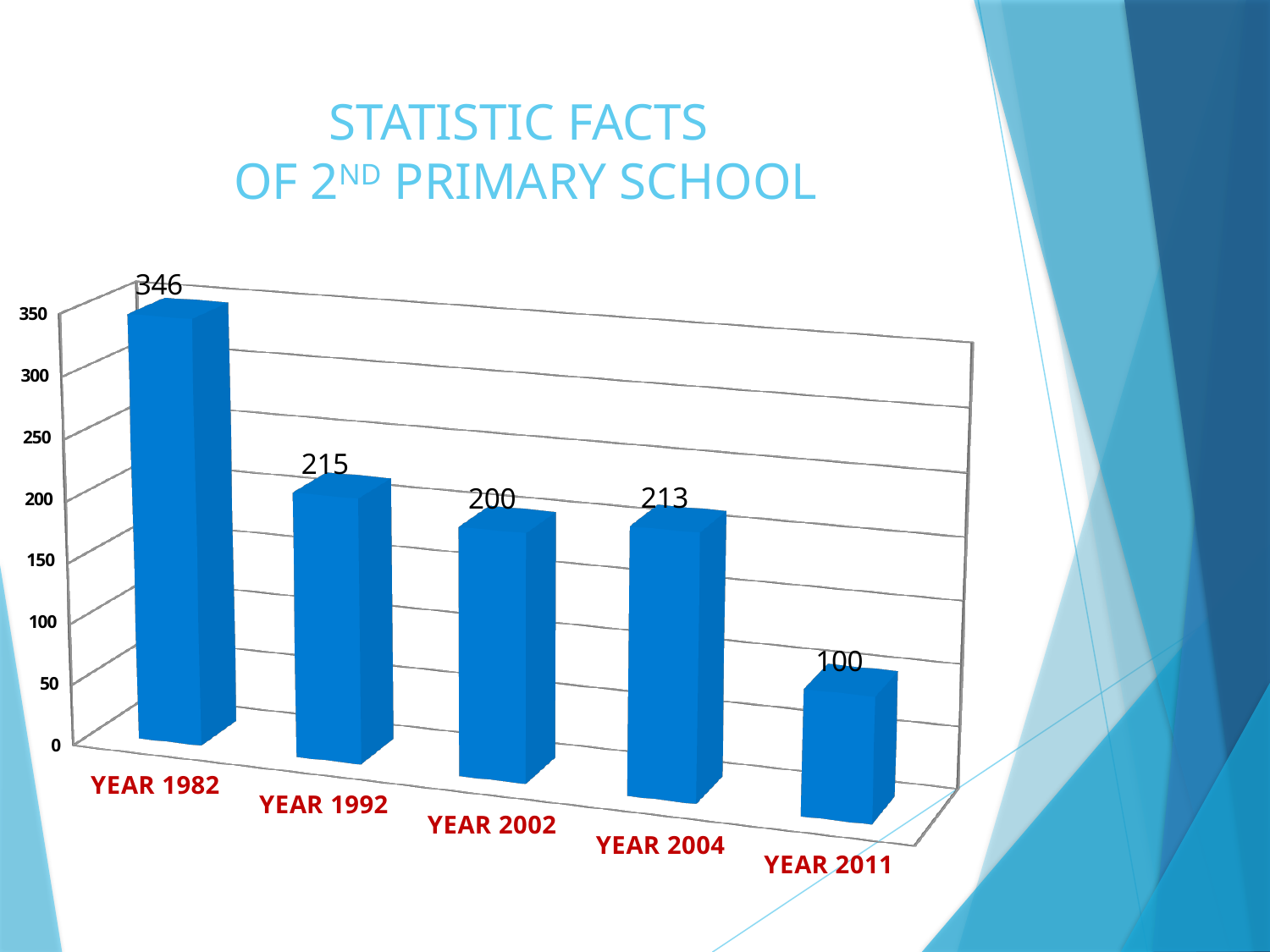
What is the title of the slide? STATISTIC FACTS OF 2ND PRIMARY SCHOOL Which year has the highest value? YEAR 1982 What is the value for YEAR 2004? 213 What is the difference between the values for YEAR 1982 and YEAR 1992? 131 What is the difference between the values for YEAR 2004 and YEAR 2011? 113 What is the value for YEAR 2011? 100 Is the value for YEAR 2002 greater or less than 250? less What is the value for YEAR 1982? 346 Which is larger, the value for YEAR 1992 or the value for YEAR 2002? YEAR 1992 What kind of chart is shown on the slide? bar chart Which year has the lowest value? YEAR 2011 How many years are shown on the chart? 5